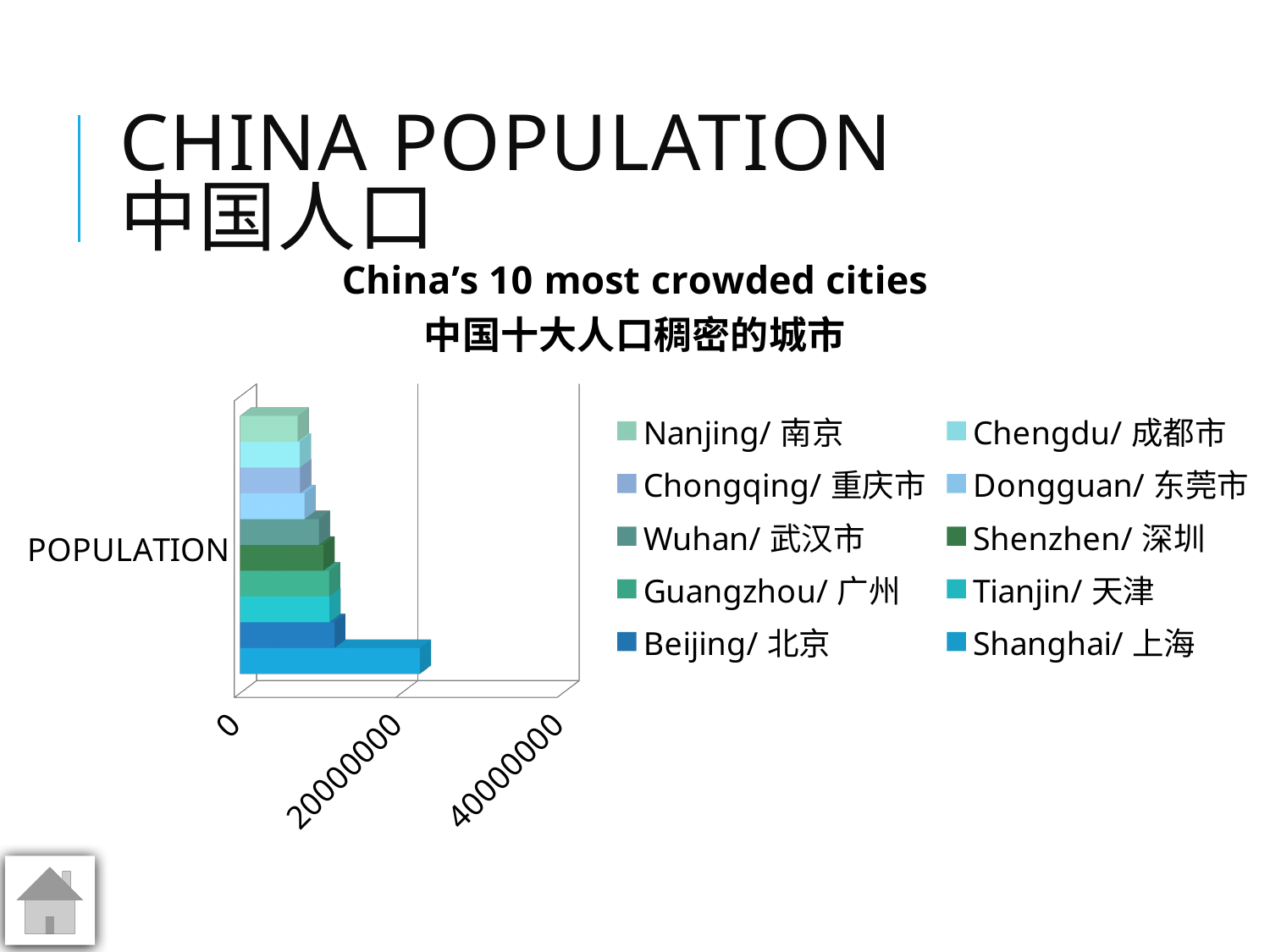
Is the value for Nanjing greater or less than 20000000? less How many series does the chart legend list? 10 Which is larger, the population of Beijing or Nanjing? Beijing Is the value for Shanghai greater or less than 20000000? greater What kind of chart is shown on the slide? bar chart Which city has the highest population in the chart? Shanghai/ 上海 How many categories are plotted on the vertical axis? 1 Is the value for Beijing greater or less than 20000000? less What is the label of the single category on the vertical axis? POPULATION What is the title of the chart? China's 10 most crowded cities 中国十大人口稠密的城市 Which is larger, the population of Shanghai or Tianjin? Shanghai Which is larger, the population of Shanghai or Beijing? Shanghai